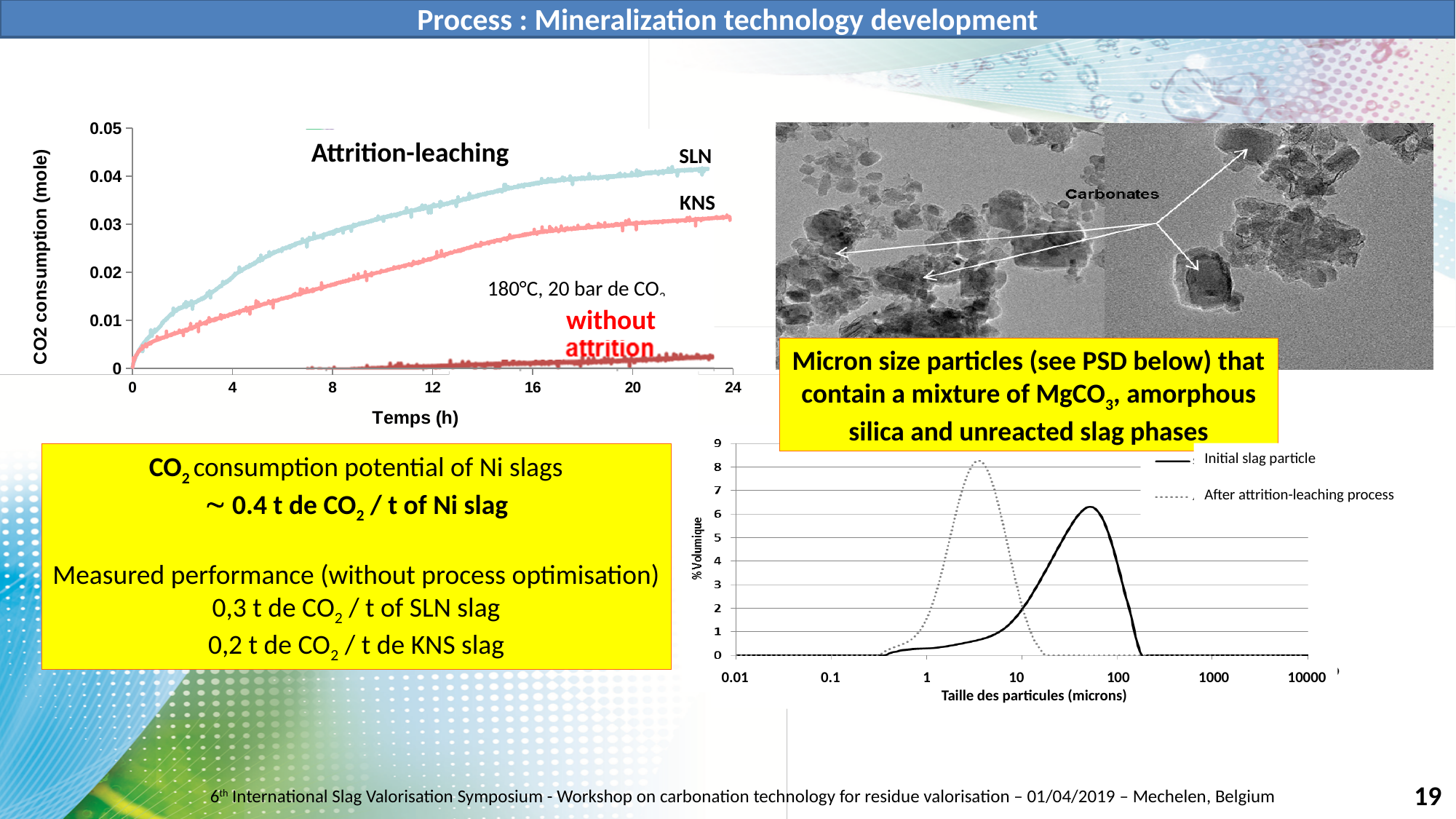
In the top-left CO2 consumption chart, is the SLN value at 20 h greater or less than 0.03 mole? greater In the top-left CO2 consumption chart, which series stays lowest over the whole time range? without attrition In the top-left CO2 consumption chart, is the KNS value at 8 h greater or less than 0.02 mole? less In the bottom-right particle size distribution chart, which series has the higher peak, Initial slag particle or After attrition-leaching process? After attrition-leaching process In the bottom-right particle size distribution chart, is the peak of the Initial slag particle curve greater or less than 5 % Volumique? greater How many series does the legend of the bottom-right particle size distribution chart list? 2 In the top-left CO2 consumption chart, which series reaches the highest value at the end of the 24 h period? SLN What kind of chart is the top-left chart showing CO2 consumption versus time? line chart In the top-left CO2 consumption chart, which series is higher at 12 h, SLN or KNS? SLN What is the x-axis label of the top-left CO2 consumption chart? Temps (h) What is the x-axis label of the bottom-right particle size distribution chart? Taille des particules (microns) In the top-left CO2 consumption chart, does the SLN curve rise or fall as time increases? rises